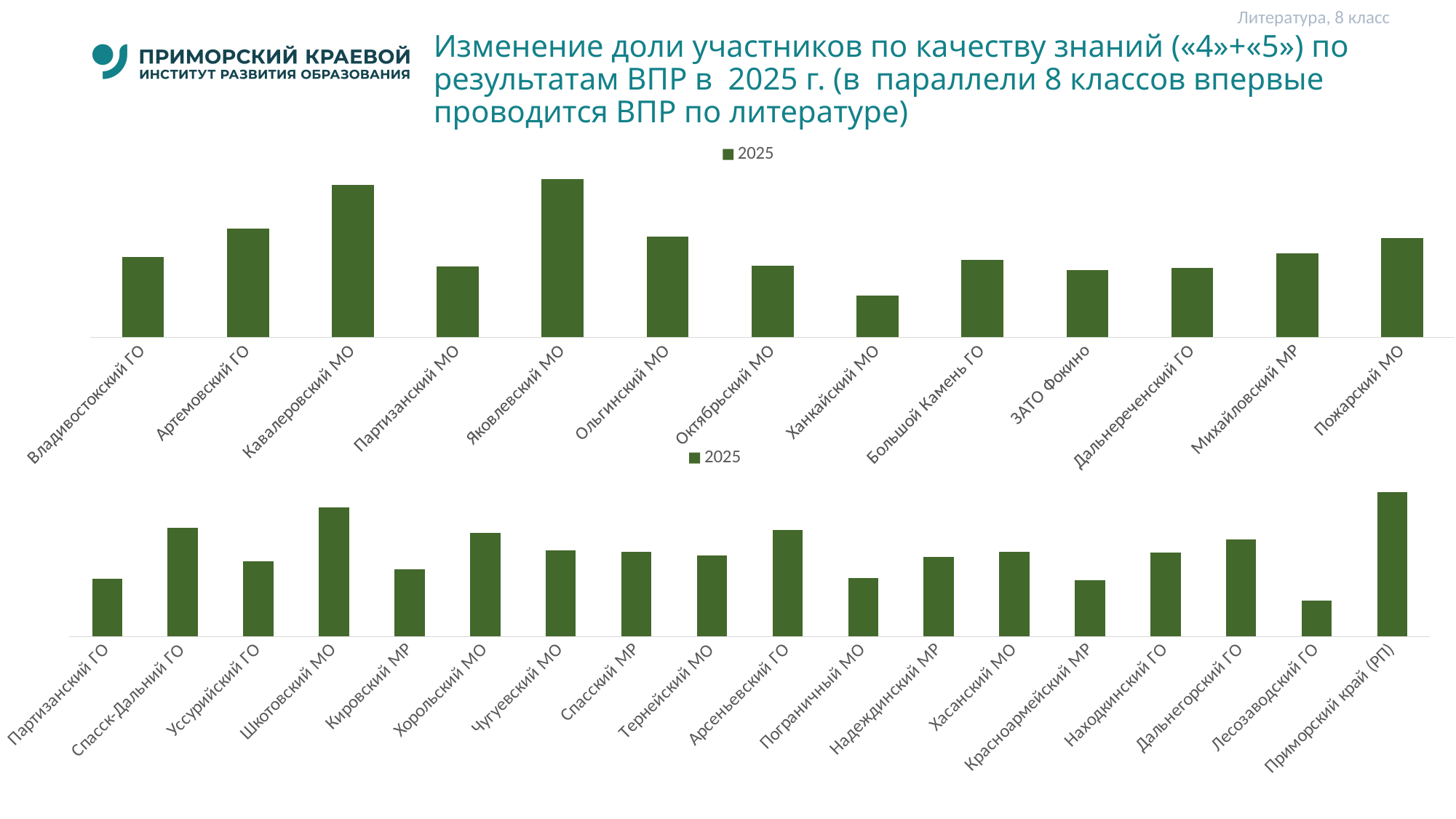
In the top chart, which is larger: the value for Ольгинский МО or for Ханкайский МО? Ольгинский МО In the bottom chart, which category has the highest bar? Приморский край (РП) How many categories are shown in the top chart? 13 How many categories are shown in the bottom chart? 18 In the bottom chart, which is larger: the value for Шкотовский МО or for Партизанский ГО? Шкотовский МО In the bottom chart, which category has the lowest bar? Лесозаводский ГО What series name is shown in the legend of the top chart? 2025 What kind of chart is the top chart on the slide? bar chart In the top chart, which is larger: the value for Кавалеровский МО or for Владивостокский ГО? Кавалеровский МО In the top chart, which category has the lowest bar? Ханкайский МО How many series does the legend of the bottom chart list? 1 In the top chart, which category has the highest bar? Яковлевский МО